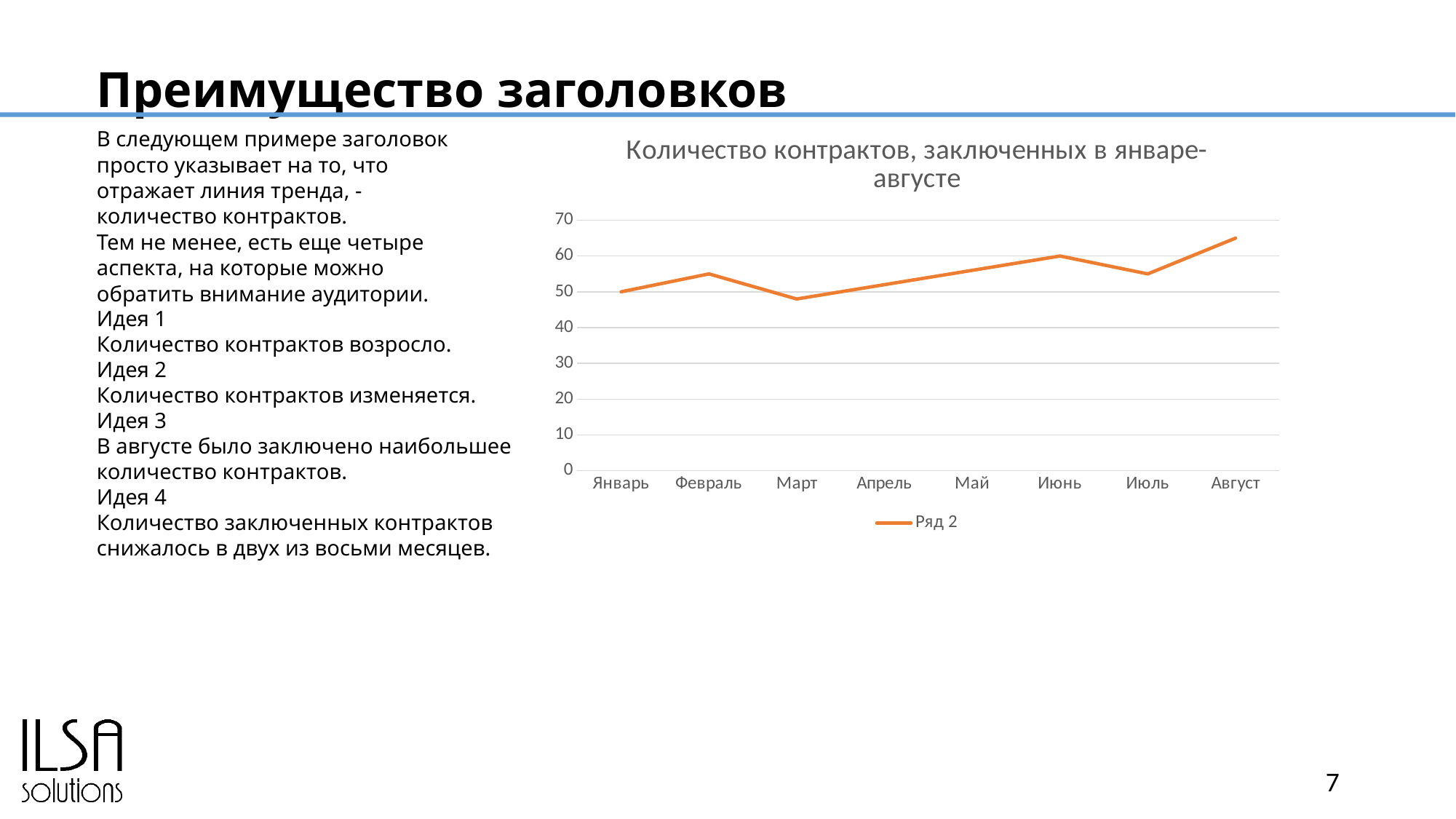
What is the value for Январь? 50 How many months are plotted on the x axis of the chart? 8 How many series does the chart legend list? 1 What is the difference between the values for Июнь and Январь? 10 Is the value for Март greater or less than 50? less What is the title of the chart? Количество контрактов, заключенных в январе-августе What is the value for Июнь? 60 What kind of chart is shown on the slide? line chart Is the value for Август greater or less than 60? greater What is the name of the series shown in the chart legend? Ряд 2 Which month has the lowest value in the chart? Март Which month has the highest value in the chart? Август